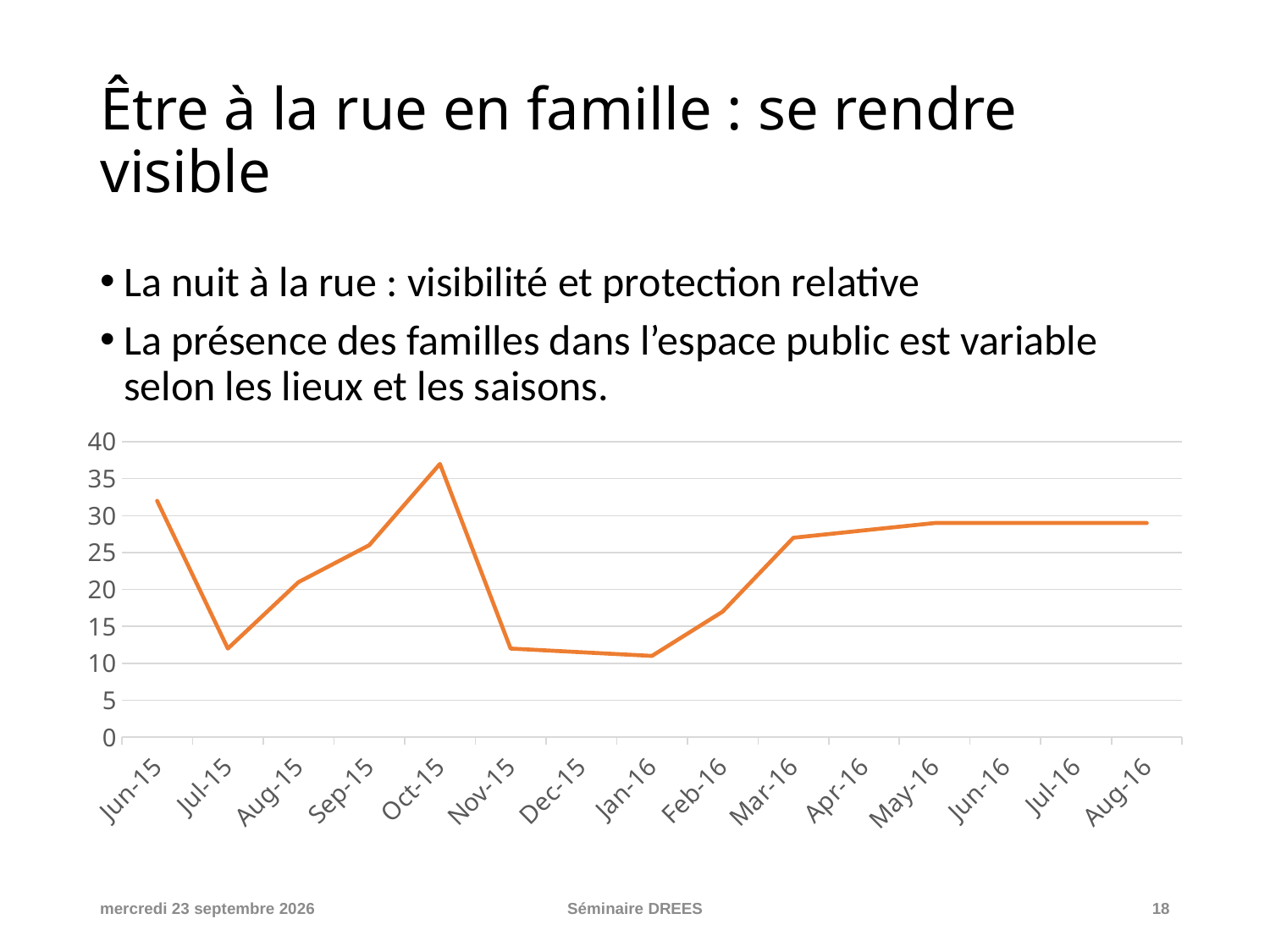
Which is larger, the value for Feb-16 or the value for Mar-16? Mar-16 Do the values rise or fall from Oct-15 to Nov-15? fall Is the value for Jan-16 greater or less than 15? less Do the values rise or fall from Jul-15 to Oct-15? rise Is the value for Oct-15 greater or less than 35? greater Which month has the highest value on the chart? Oct-15 Is the value for Mar-16 greater or less than 25? greater Which is larger, the value for Jun-15 or the value for Jul-15? Jun-15 What kind of chart is shown on the slide? line chart